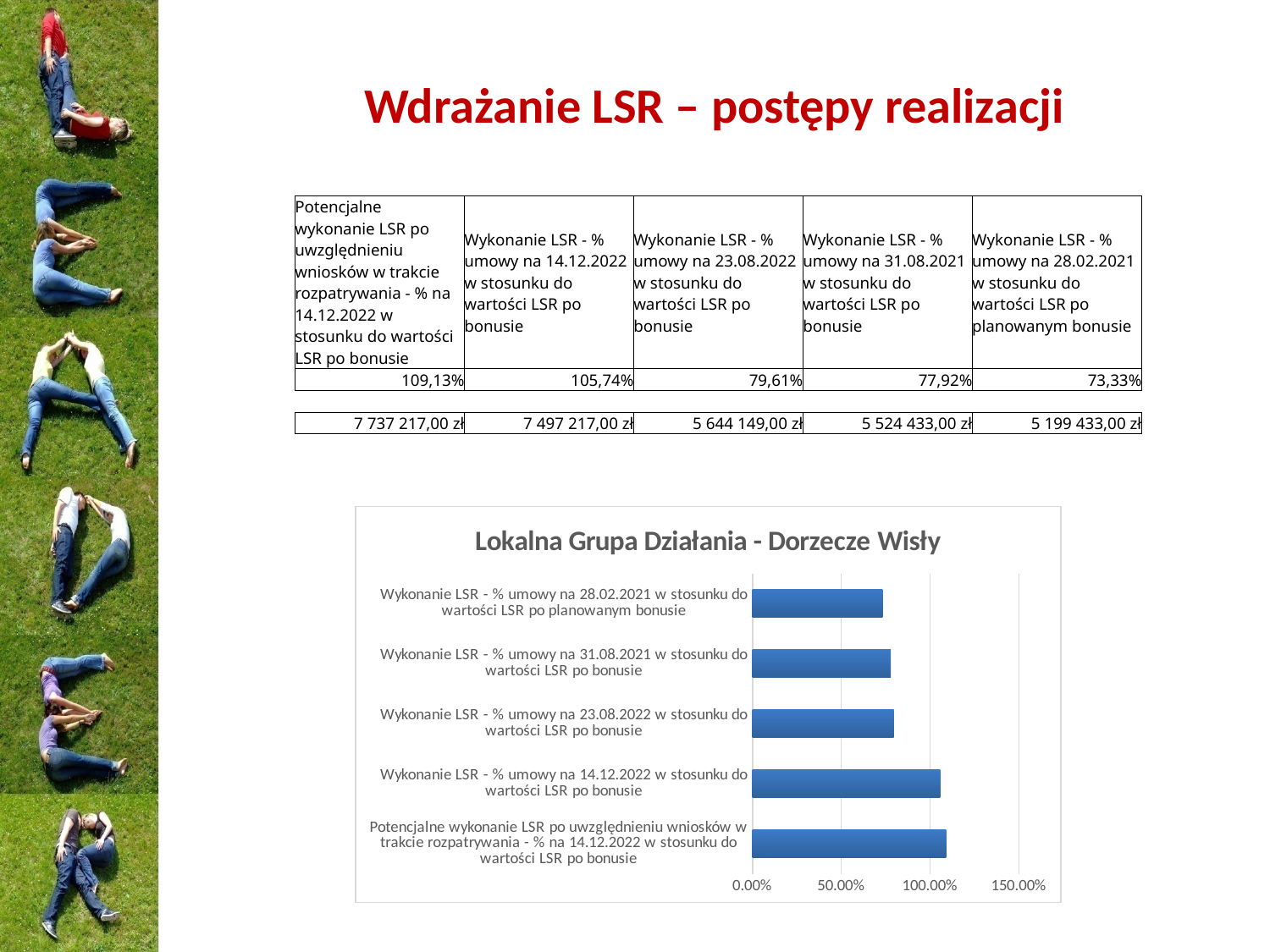
Which category has the highest value in the chart? Potencjalne wykonanie LSR po uwzględnieniu wniosków w trakcie rozpatrywania - % na 14.12.2022 w stosunku do wartości LSR po bonusie Is the value for "Wykonanie LSR - % umowy na 23.08.2022 w stosunku do wartości LSR po bonusie" greater or less than 50.00%? greater Is the value for "Wykonanie LSR - % umowy na 14.12.2022 w stosunku do wartości LSR po bonusie" greater or less than 100.00%? greater What is the highest tick value shown on the chart's horizontal axis? 150.00% What is the title of the chart? Lokalna Grupa Działania - Dorzecze Wisły Is the value for "Wykonanie LSR - % umowy na 28.02.2021 w stosunku do wartości LSR po planowanym bonusie" greater or less than 100.00%? less How many categories (bars) does the chart show? 5 Which category has the lowest value in the chart? Wykonanie LSR - % umowy na 28.02.2021 w stosunku do wartości LSR po planowanym bonusie Which is larger: the value for "Wykonanie LSR - % umowy na 14.12.2022 w stosunku do wartości LSR po bonusie" or for "Wykonanie LSR - % umowy na 23.08.2022 w stosunku do wartości LSR po bonusie"? Wykonanie LSR - % umowy na 14.12.2022 w stosunku do wartości LSR po bonusie What kind of chart is shown on the slide? bar chart